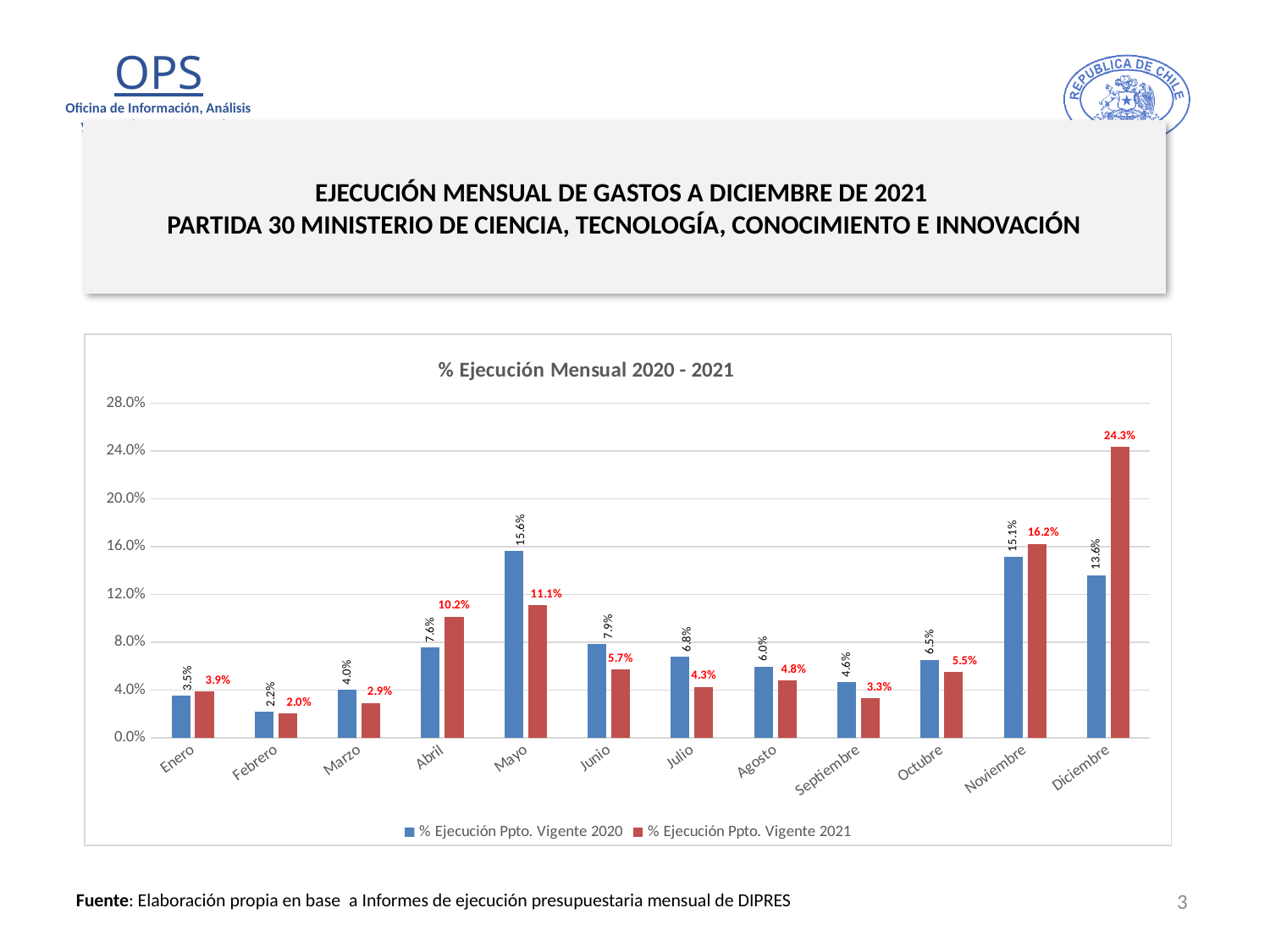
Which month has the lowest value in the % Ejecución Ppto. Vigente 2021 series? Febrero What kind of chart is shown on the slide? Bar chart What is the title of the chart? % Ejecución Mensual 2020 - 2021 Is the value for Noviembre in the % Ejecución Ppto. Vigente 2021 series greater or less than 12.0%? greater What is the difference between the 2021 and 2020 values for Diciembre? 10.7% What is the value for Abril in the % Ejecución Ppto. Vigente 2021 series? 10.2% What is the value for Diciembre in the % Ejecución Ppto. Vigente 2021 series? 24.3% How many months are shown on the x axis of the chart? 12 What is the value for Mayo in the % Ejecución Ppto. Vigente 2020 series? 15.6% Which is larger for Mayo: the % Ejecución Ppto. Vigente 2020 value or the % Ejecución Ppto. Vigente 2021 value? % Ejecución Ppto. Vigente 2020 Which month has the highest value in the % Ejecución Ppto. Vigente 2020 series? Mayo How many series does the chart legend list? 2